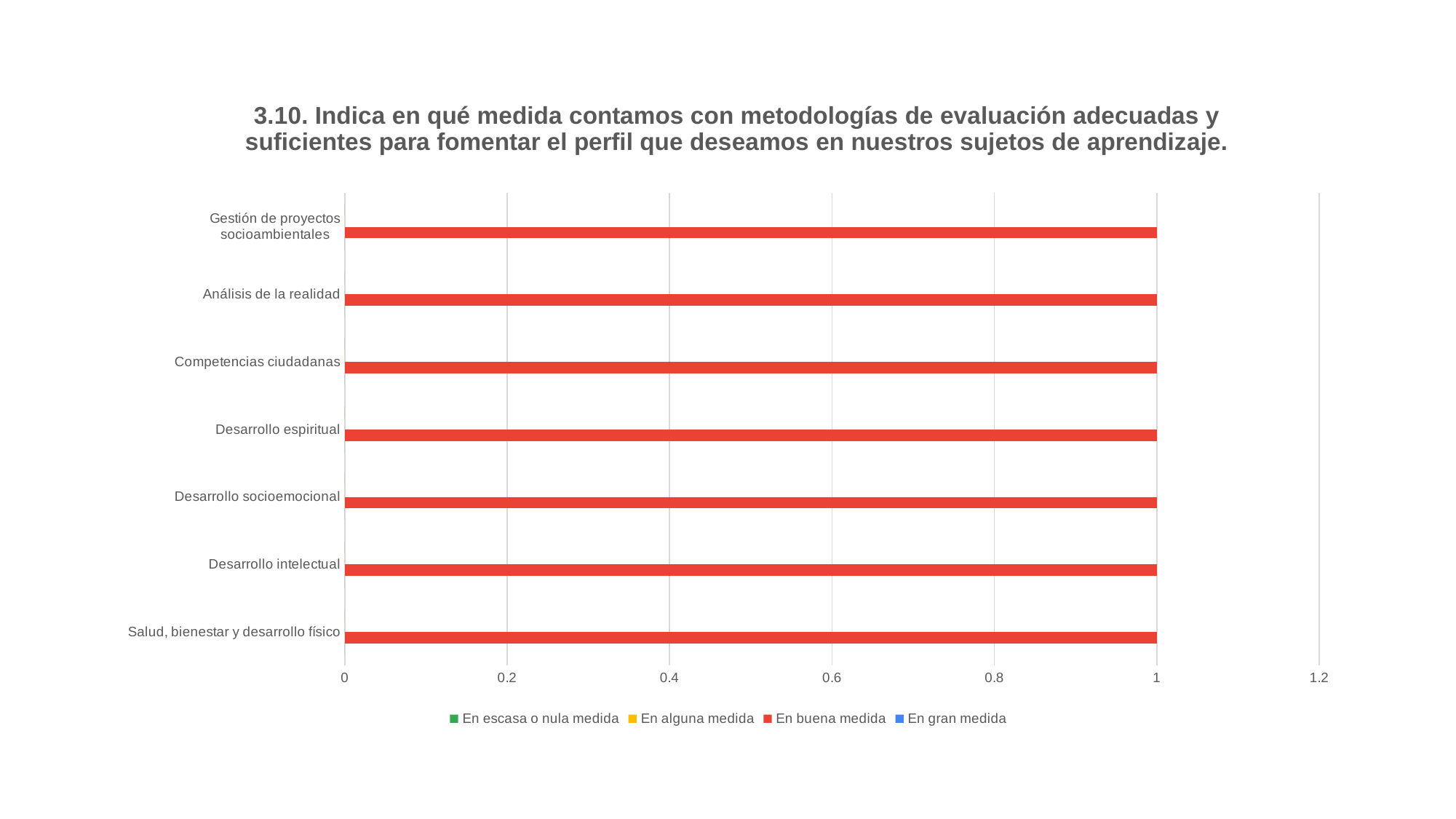
What is the difference between the 'En buena medida' values for 'Gestión de proyectos socioambientales' and 'Desarrollo socioemocional'? 0 How many series does the chart's legend list? 4 What is the value of the 'En buena medida' bar for 'Análisis de la realidad'? 1 Is the 'En buena medida' value for 'Desarrollo espiritual' greater or less than 1.2? less What is the value of the 'En buena medida' bar for 'Salud, bienestar y desarrollo físico'? 1 Which series in the legend is shown in blue? En gran medida What is the value of the 'En buena medida' bar for 'Desarrollo intelectual'? 1 What is the highest value shown on the horizontal axis of the chart? 1.2 Is the 'En buena medida' value for 'Competencias ciudadanas' greater or less than 0.8? greater How many categories are listed on the vertical axis of the chart? 7 Which series in the legend is shown in red? En buena medida What kind of chart is shown on the slide? bar chart